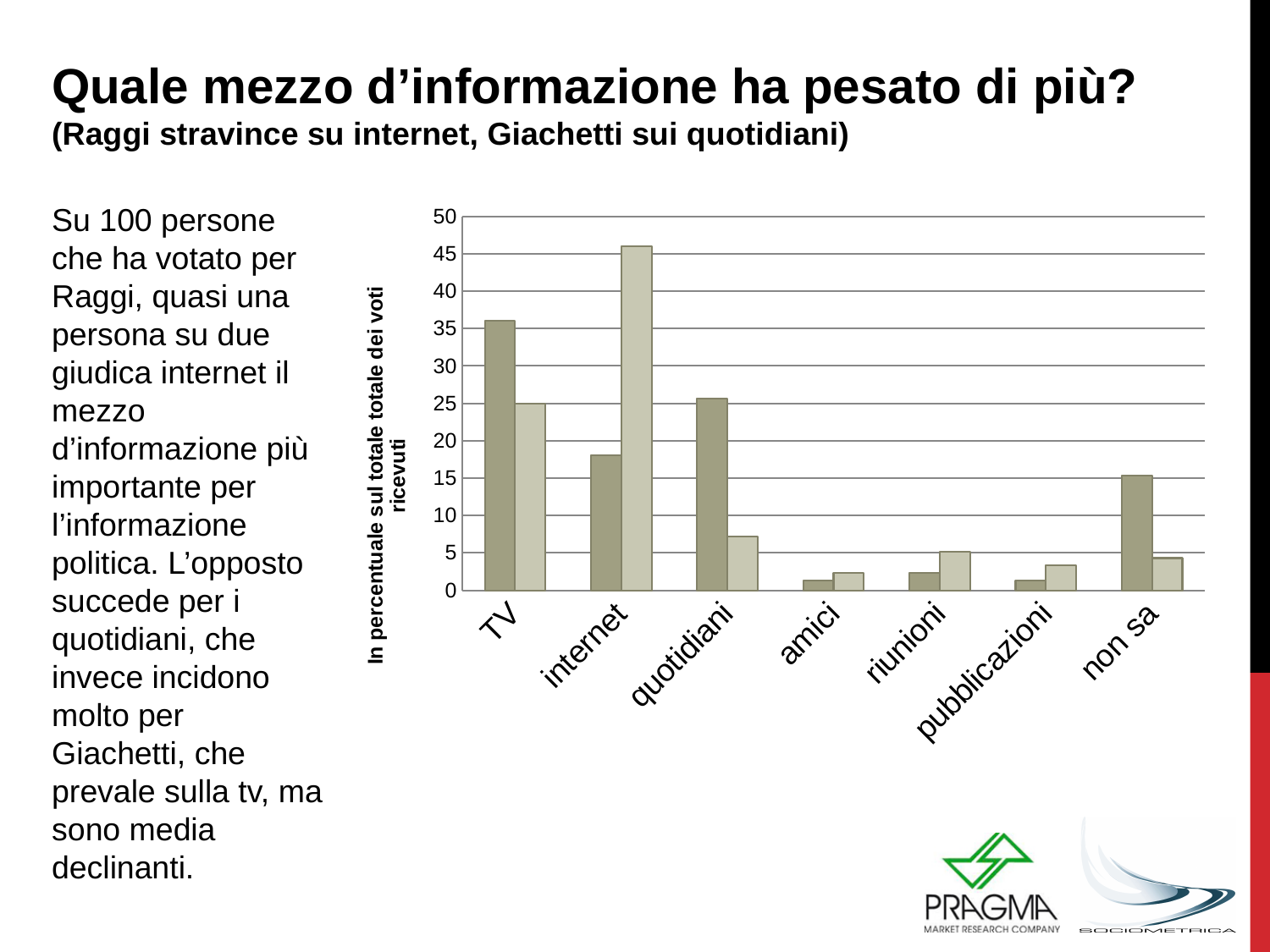
Which category has the highest value among the lighter bars? internet For internet, which bar is larger, the darker one or the lighter one? the lighter one What is the highest value shown on the vertical axis of the chart? 50 Which category has the highest value among the darker bars? TV What kind of chart is shown on the slide? bar chart Is the value of the darker bar for TV greater or less than 30? greater How many categories are shown on the x axis of the chart? 7 Is the value of the lighter bar for quotidiani greater or less than 10? less What is the label of the vertical axis of the chart? In percentuale sul totale dei voti ricevuti For quotidiani, which bar is larger, the darker one or the lighter one? the darker one Is the value of the darker bar for non sa greater or less than 10? greater